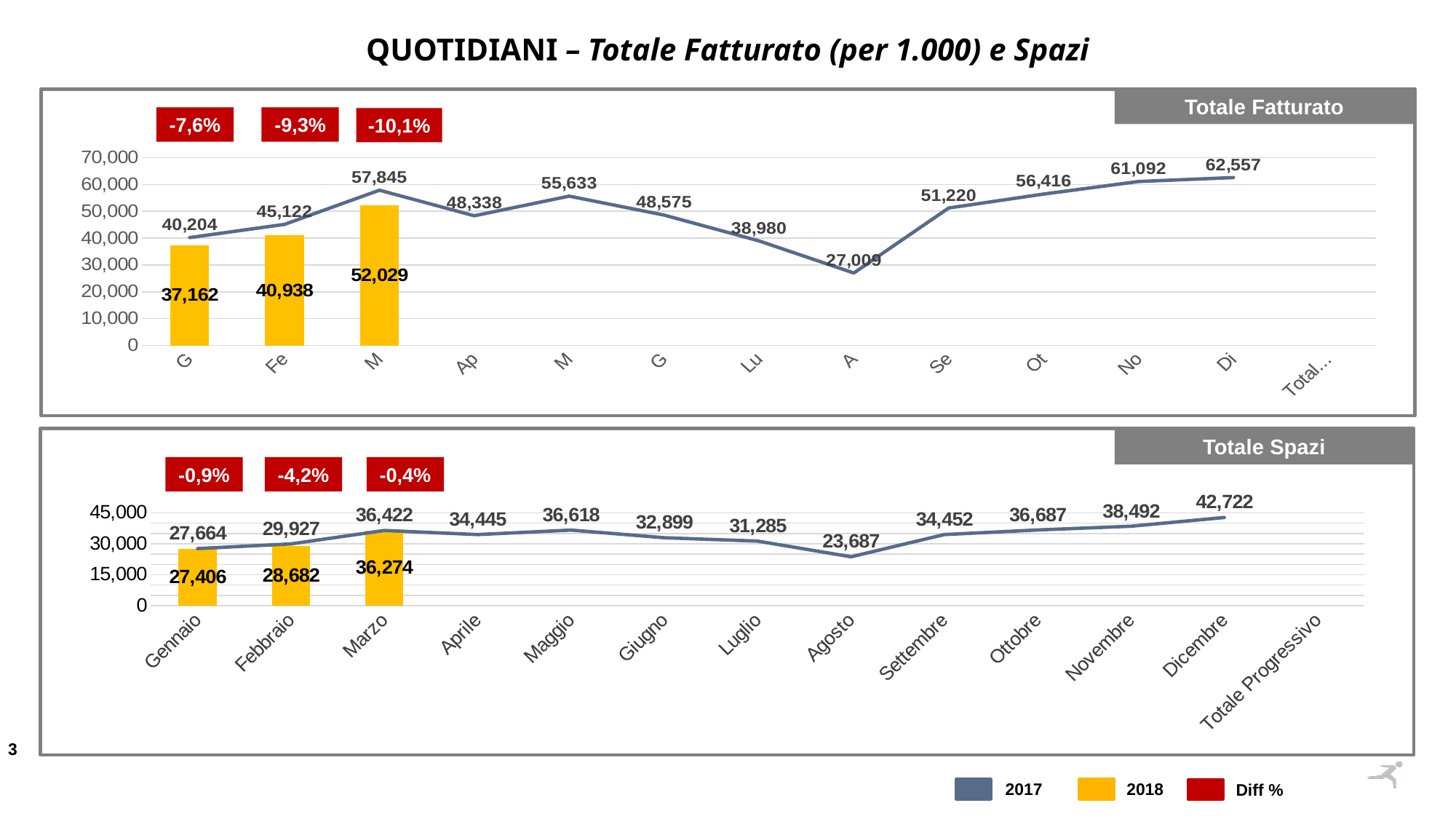
In the Totale Fatturato chart, which category has the lowest 2017 value? A In the Totale Fatturato chart, what is the 2018 value shown on the bar for Fe? 40,938 In the Totale Fatturato chart, what is the difference between the 2017 value (40,204) and the 2018 value (37,162) for the first category, G? 3,042 In the Totale Fatturato chart, which category has the highest 2017 value? Di In the Totale Spazi chart, what is the 2018 value for Marzo? 36,274 In the Totale Spazi chart, which has the larger 2017 value, Maggio or Giugno? Maggio In the Totale Fatturato chart, what is the 2017 value for Di? 62,557 In the Totale Fatturato chart, what Diff % is shown above the third category, M? -10,1% How many series does the legend at the bottom of the slide list? 3 In the Totale Spazi chart, which month has the lowest 2017 value? Agosto In the Totale Spazi chart, what is the 2017 value for Agosto? 23,687 In the Totale Spazi chart, what is the difference between the 2017 value and the 2018 value for Febbraio? 1,245